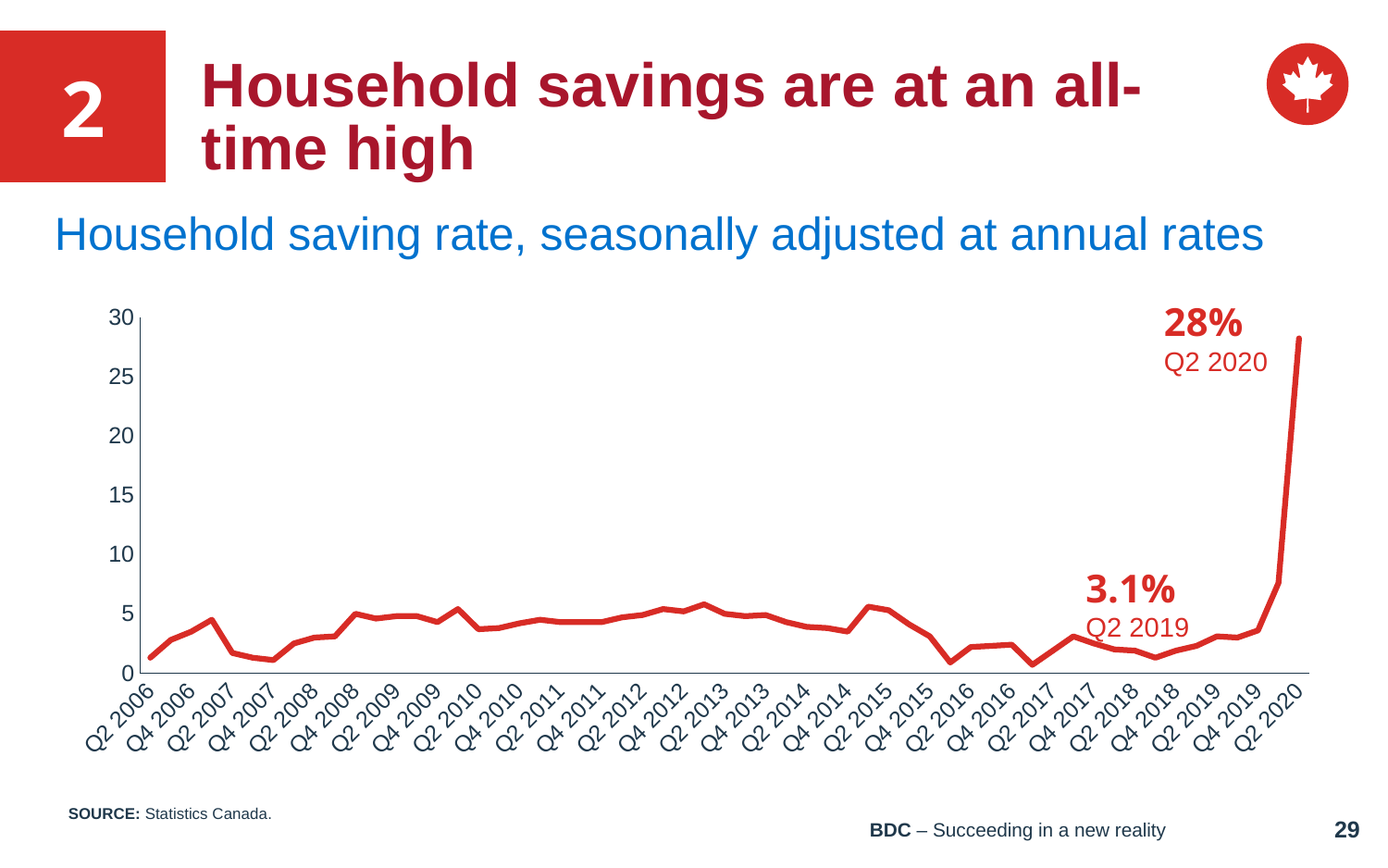
Is the household saving rate for Q2 2015 greater or less than 10? less How many lines (data series) are plotted on the chart? 1 Which is larger, the saving rate in Q2 2019 or in Q2 2020? Q2 2020 What is the title of the chart? Household saving rate, seasonally adjusted at annual rates Is the household saving rate for Q2 2020 greater or less than 25? greater Which quarter has the highest household saving rate on the chart? Q2 2020 What is the household saving rate shown for Q2 2020? 28% Does the household saving rate rise or fall between Q2 2019 and Q2 2020? rise By how many percentage points does the Q2 2020 saving rate exceed the Q2 2019 saving rate? 24.9 percentage points What kind of chart is used to show the household saving rate? line chart What is the household saving rate shown for Q2 2019? 3.1% Is the household saving rate for Q2 2016 greater or less than 5? less